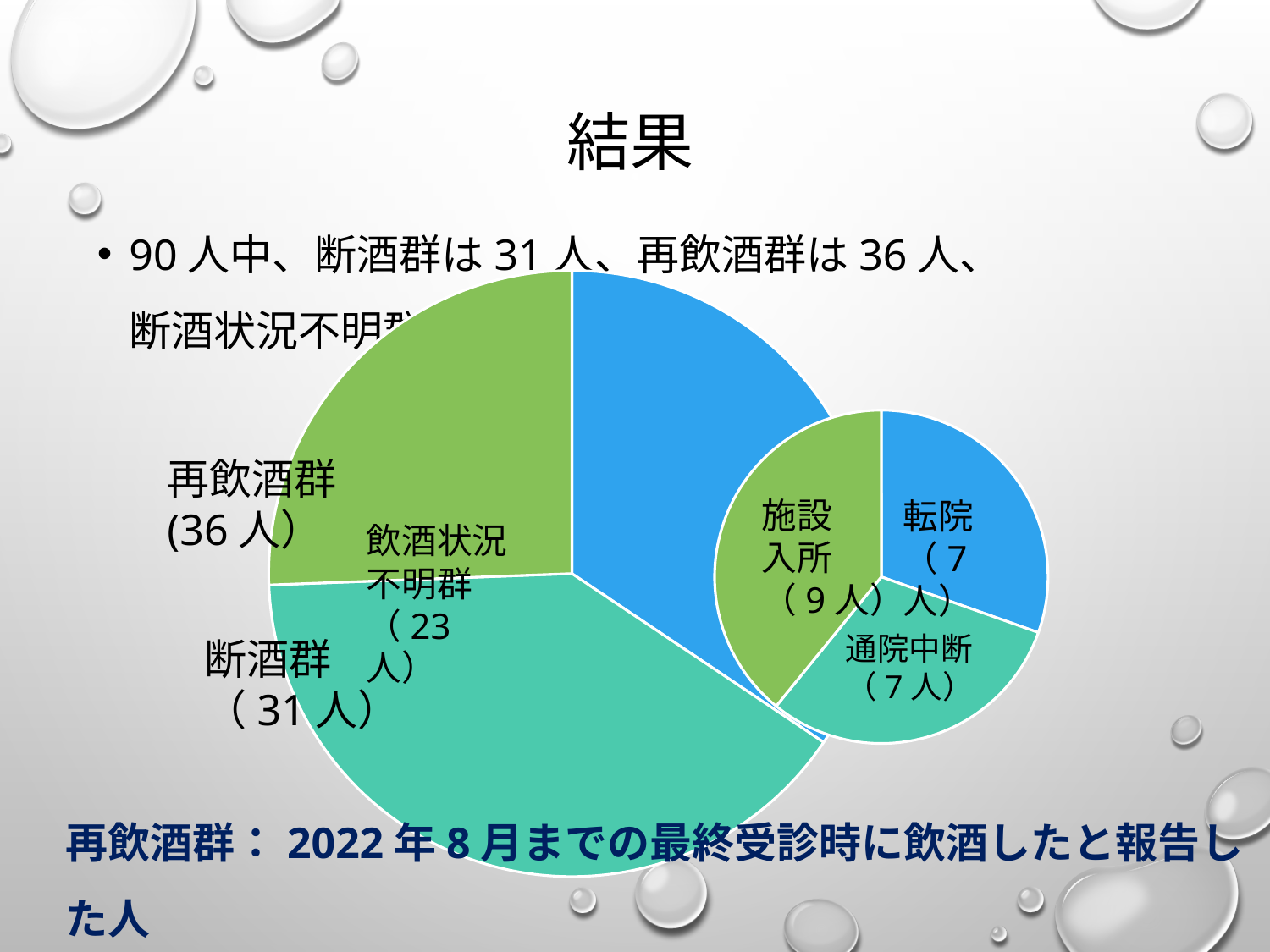
In the large pie chart on the left, which group has the most people? 再飲酒群 In the large pie chart on the left, how many people are in the 飲酒状況不明群 group? 23人 In the large pie chart on the left, how many people are in the 再飲酒群 group? 36人 In the large pie chart on the left, what is the difference in people between 再飲酒群 and 断酒群? 5人 In the large pie chart on the left, how many people are in the 断酒群 group? 31人 In the small pie chart on the right, which category has the most people? 施設入所 In the small pie chart on the right, what is the total number of people across all slices? 23人 What kind of chart is the large chart on the left? pie chart In the large pie chart on the left, which group has the fewest people? 飲酒状況不明群 In the small pie chart on the right, how many people are in 転院? 7人 In the large pie chart on the left, how many slices are there? 3 In the small pie chart on the right, how many people are in 施設入所? 9人